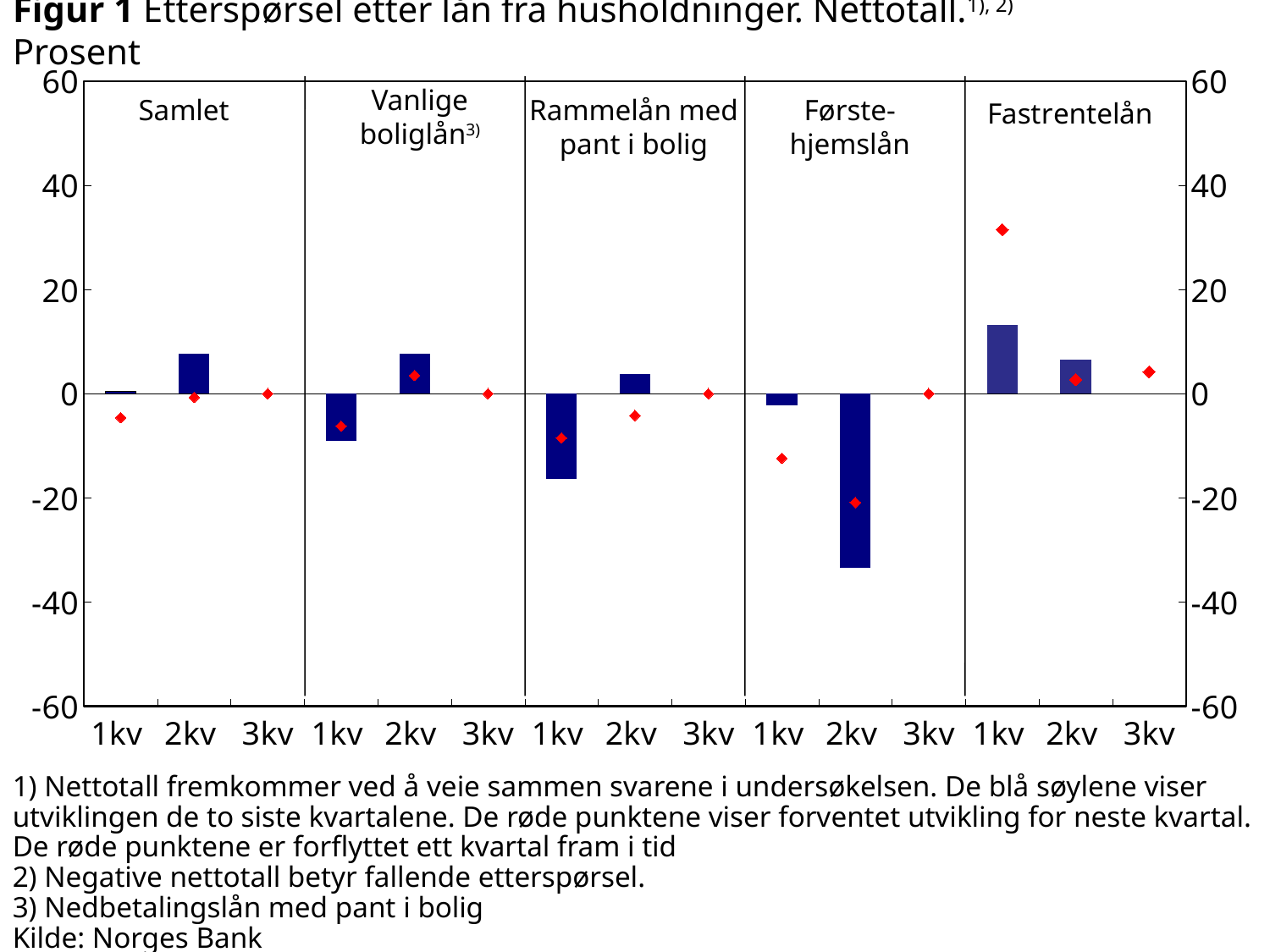
Is the 1kv bar for Fastrentelån greater or less than 10? greater Is the 2kv bar for Førstehjemslån greater or less than -20? less Which loan category has the highest bar for 1kv? Fastrentelån What colour are the bars in the chart? blue In the Fastrentelån panel, do the bars rise or fall from 1kv to 2kv? fall Which loan category has the lowest bar for 2kv? Førstehjemslån How many loan categories (panels) does the chart show? 5 Is the 1kv bar for Rammelån med pant i bolig greater or less than -20? greater What kind of chart is shown in Figur 1? bar chart How many quarters are labelled on the x axis within each panel? 3 Which is larger: the 2kv bar for Vanlige boliglån or the 2kv bar for Rammelån med pant i bolig? Vanlige boliglån